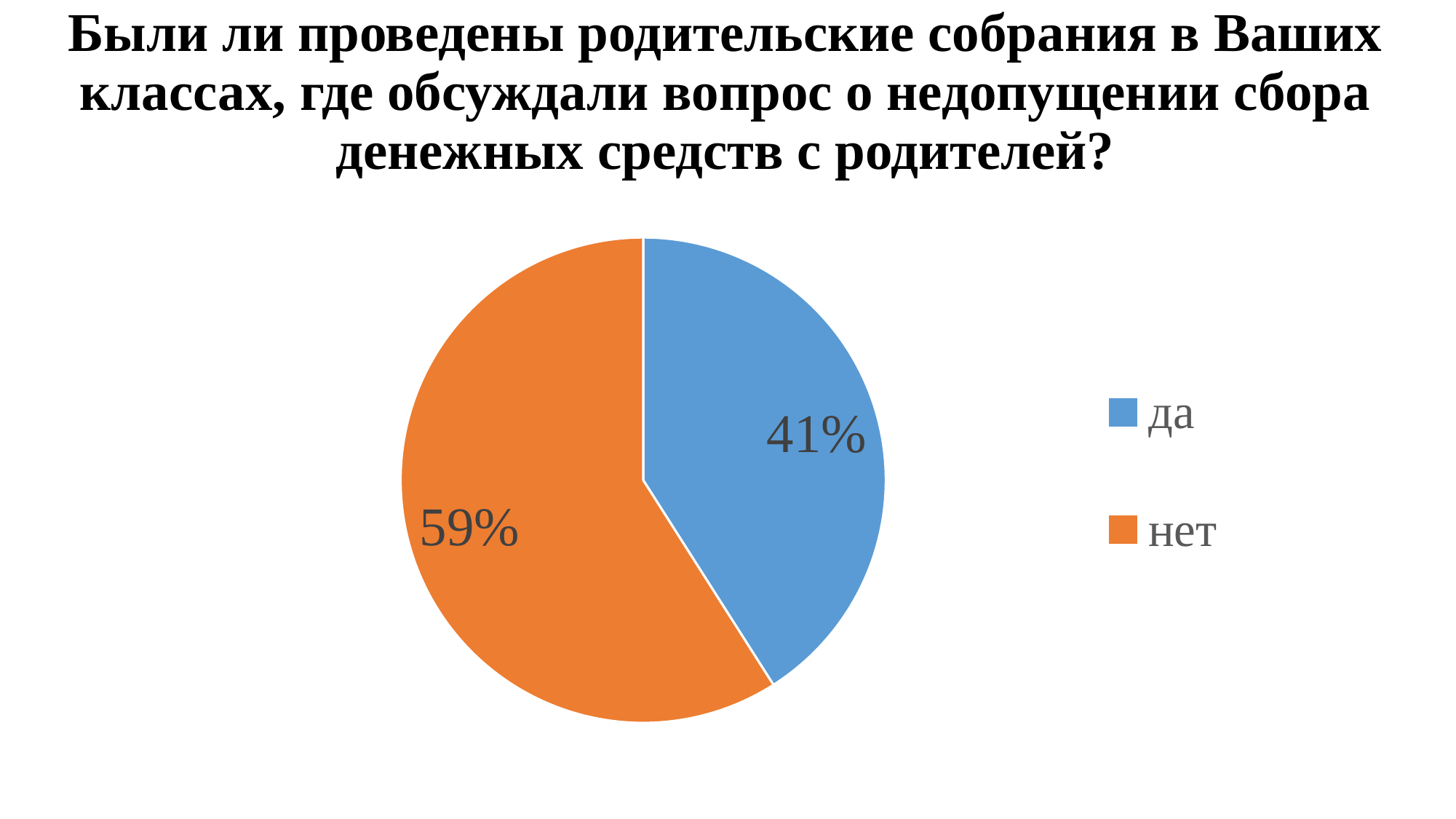
What colour is the "нет" slice? orange What colour is the "да" slice? blue What share of the pie does the "да" slice represent? 41% What is the difference in percentage points between the "нет" and "да" slices? 18 What percentage of the pie chart is labelled "нет"? 59% Which slice is larger, "да" or "нет"? нет How many entries does the legend list? 2 What percentage of the pie chart is labelled "да"? 41% Which category has the largest share of the pie chart? нет Which category has the smallest share of the pie chart? да How many slices does the pie chart have? 2 What kind of chart is shown on the slide? pie chart